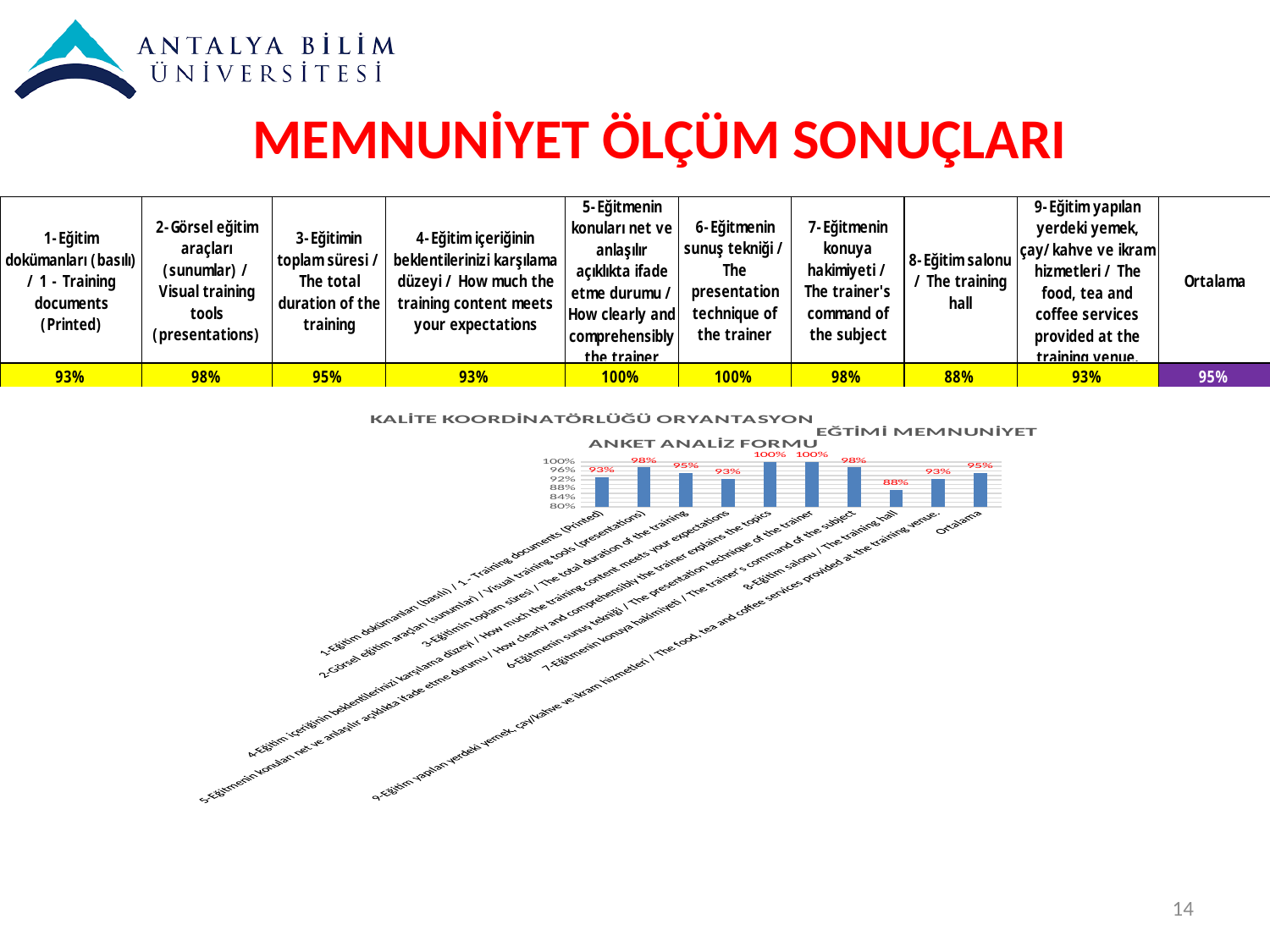
What is the lowest value shown on the chart's vertical axis? 80% What is the highest value shown in the chart? 100% How many bars are plotted in the chart? 10 What is the value shown for '2-Görsel eğitim araçları (sunumlar) / Visual training tools (presentations)' in the chart? 98% What kind of chart is shown on the slide? bar chart What is the difference between the value for '2-Görsel eğitim araçları (sunumlar)' and the value for '8-Eğitim salonu / The training hall'? 10% Which category has the lowest value in the chart? 8-Eğitim salonu / The training hall What is the value shown for '3-Eğitimin toplam süresi / The total duration of the training' in the chart? 95% Which is larger: the value for '1-Eğitim dokümanları (basılı)' or the value for '3-Eğitimin toplam süresi'? 3-Eğitimin toplam süresi What is the value shown for 'Ortalama' in the chart? 95% Is the value for '8-Eğitim salonu / The training hall' greater or less than 92%? less What is the value shown for '8-Eğitim salonu / The training hall' in the chart? 88%